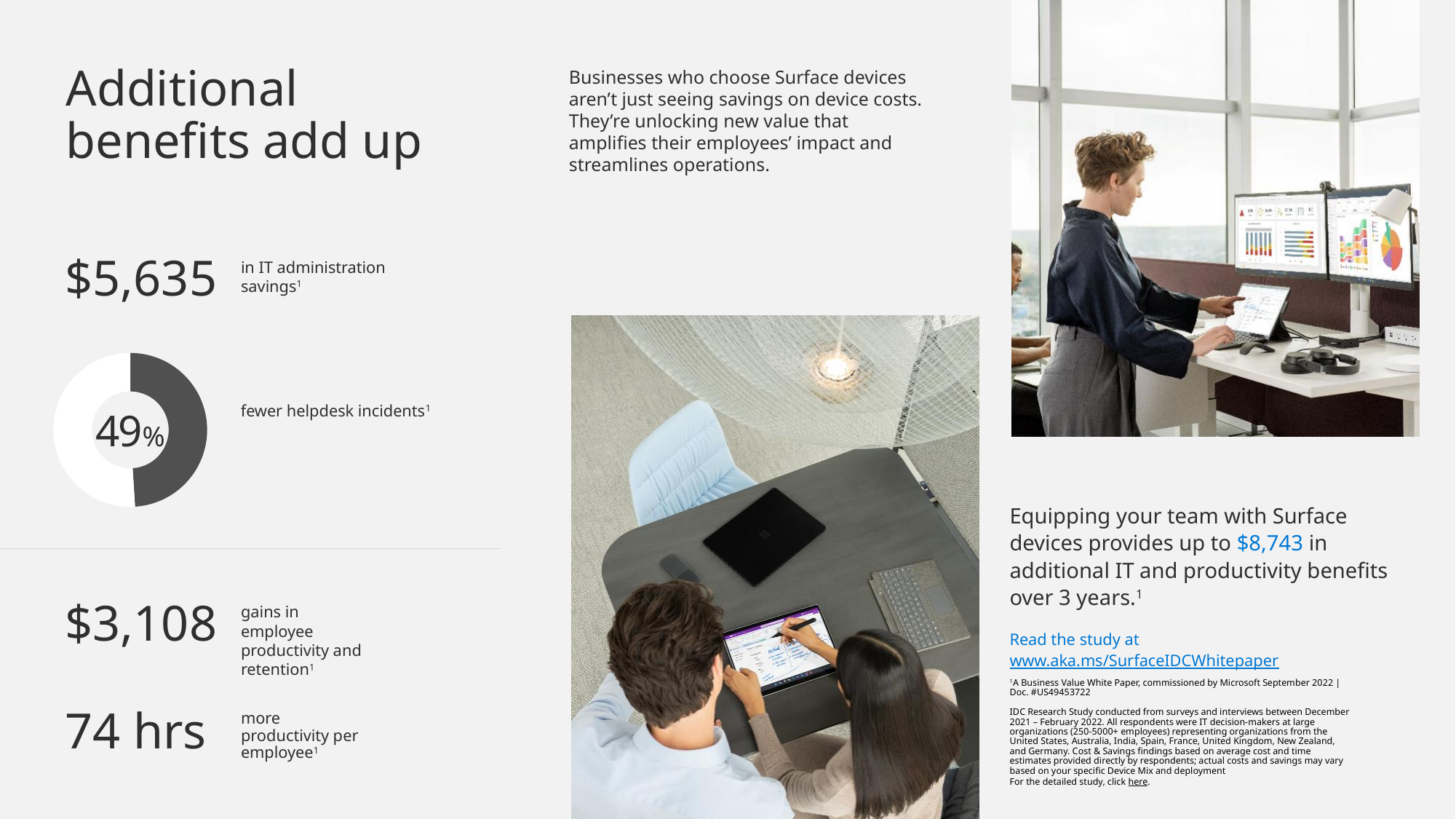
What percentage is printed in the centre of the donut chart? 49% Is the filled portion of the donut chart greater or less than 50%? less What kind of chart is shown on the left of the slide? Donut chart How many segments does the donut chart have? 2 Which segment of the donut chart is larger, the dark filled segment or the white unfilled segment? The white unfilled segment What colour is the filled segment of the donut chart? Dark grey What does the 49% in the donut chart represent? Fewer helpdesk incidents What share of the donut chart is filled by the dark segment? 49% Is the filled portion of the donut chart greater or less than 25%? greater